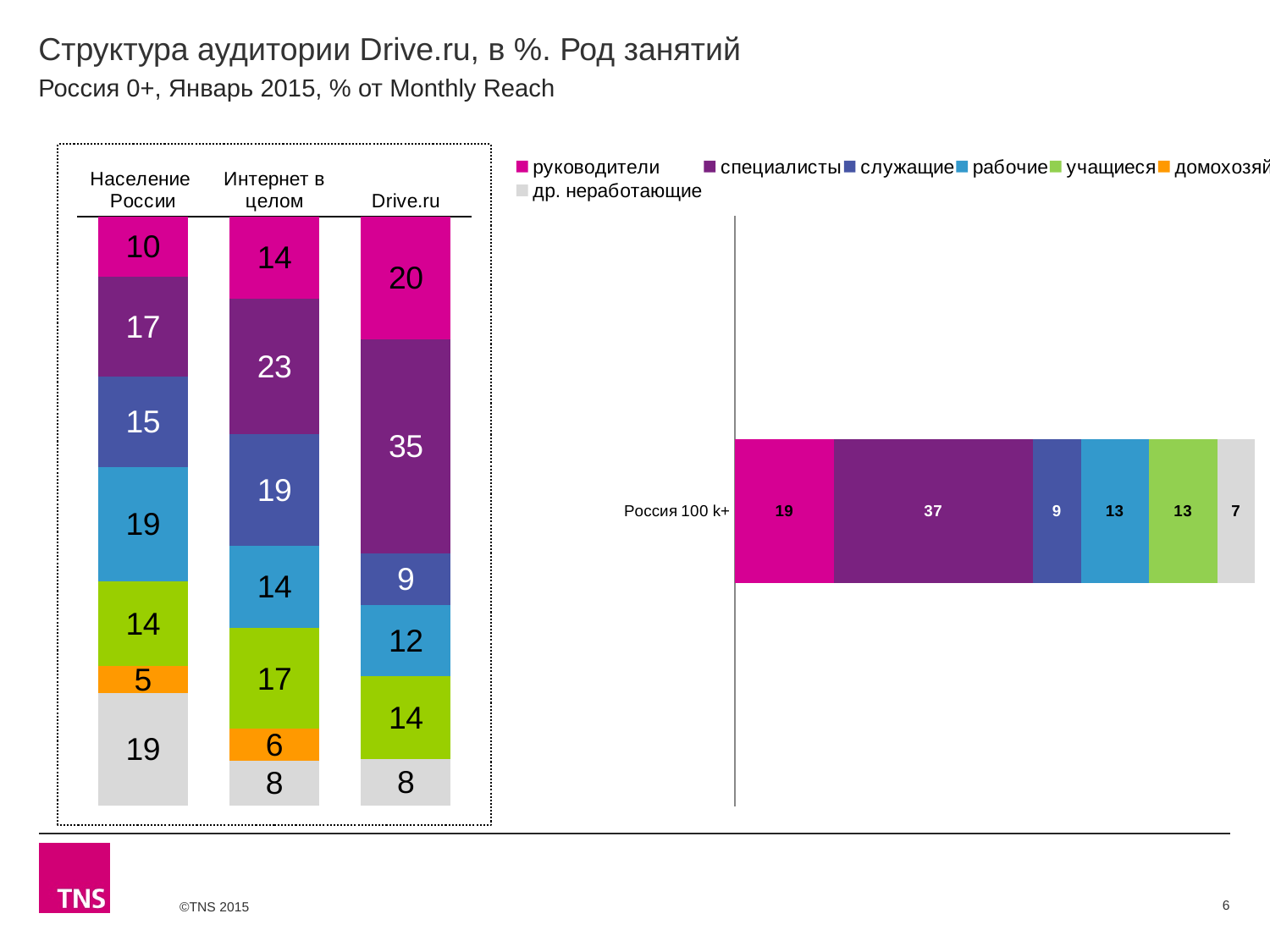
In the left chart, what is the value of the руководители segment for Население России? 10 In the left chart, is the служащие value larger for Интернет в целом or for Drive.ru? Интернет в целом What kind of chart is the right chart (Россия 100 k+)? Stacked bar chart In the left chart, which of the three columns has the largest специалисты segment? Drive.ru How many series does the legend list? 7 In the left chart, what is the value of the специалисты segment for Drive.ru? 35 In the right chart (Россия 100 k+), what is the total of the рабочие and учащиеся segments? 26 In the left chart, what is the difference between the руководители values for Drive.ru and Население России? 10 In the right chart (Россия 100 k+), what is the value of the специалисты segment? 37 In the left chart, what is the value of the учащиеся segment for Интернет в целом? 17 How many columns (categories) are shown in the left chart? 3